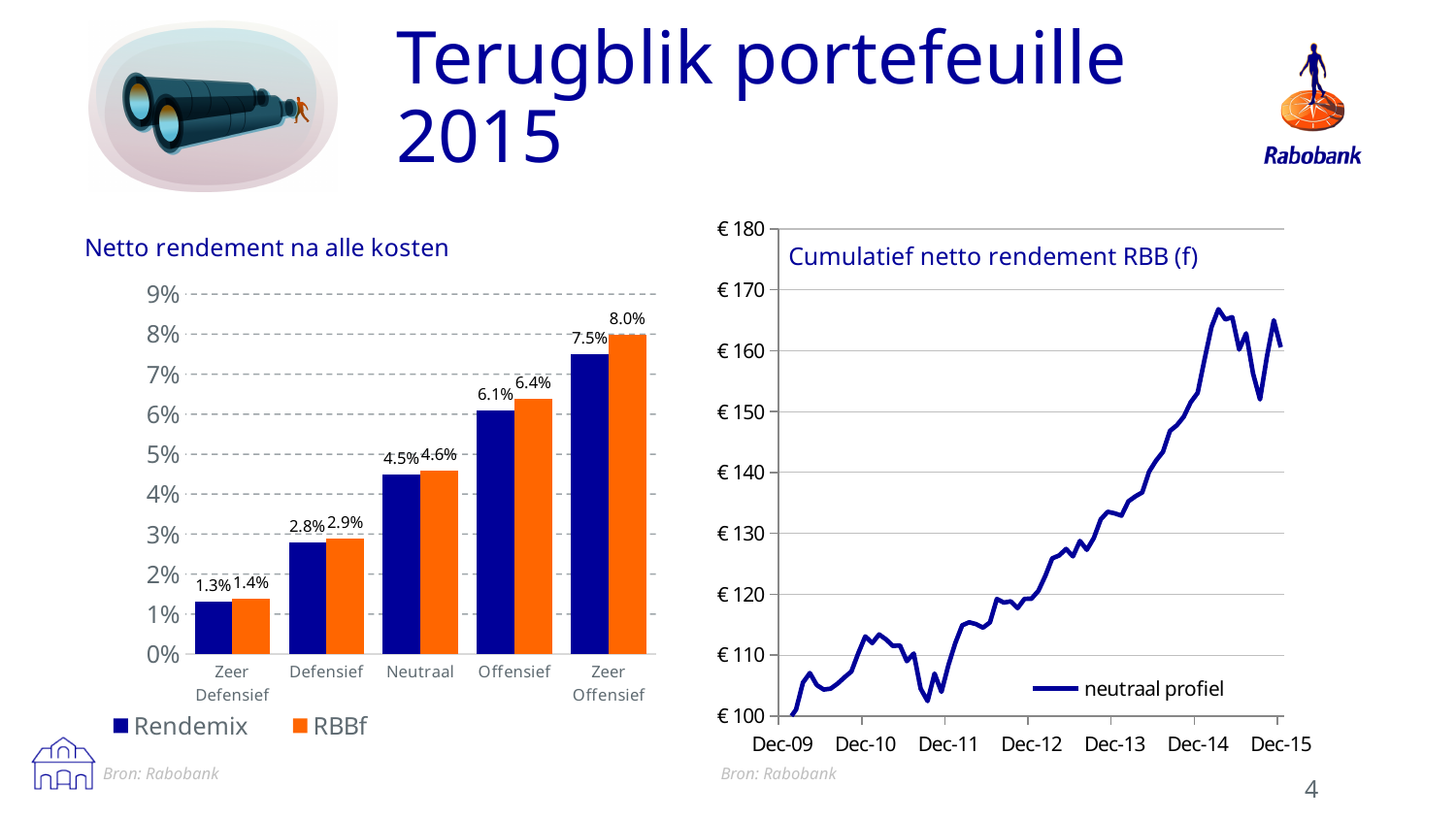
What is the name of the series shown in the legend of the 'Cumulatief netto rendement RBB (f)' chart? neutraal profiel How many categories are shown in the 'Netto rendement na alle kosten' chart? 5 How many series does the legend of the 'Netto rendement na alle kosten' chart list? 2 In the 'Netto rendement na alle kosten' chart, which is larger for Defensief: Rendemix or RBBf? RBBf In the 'Cumulatief netto rendement RBB (f)' chart, is the value at Dec-13 greater or less than € 140? less In the 'Cumulatief netto rendement RBB (f)' chart, do the values generally rise or fall from Dec-09 to Dec-15? Rise What kind of chart is the 'Netto rendement na alle kosten' chart? Bar chart In the 'Netto rendement na alle kosten' chart, which category has the lowest Rendemix value? Zeer Defensief In the 'Netto rendement na alle kosten' chart, what is the value for Rendemix in the Neutraal category? 4.5% In the 'Netto rendement na alle kosten' chart, what is the value for RBBf in the Offensief category? 6.4% In the 'Netto rendement na alle kosten' chart, what is the difference between the RBBf and Rendemix values for Zeer Offensief? 0.5% In the 'Netto rendement na alle kosten' chart, which category has the highest RBBf value? Zeer Offensief